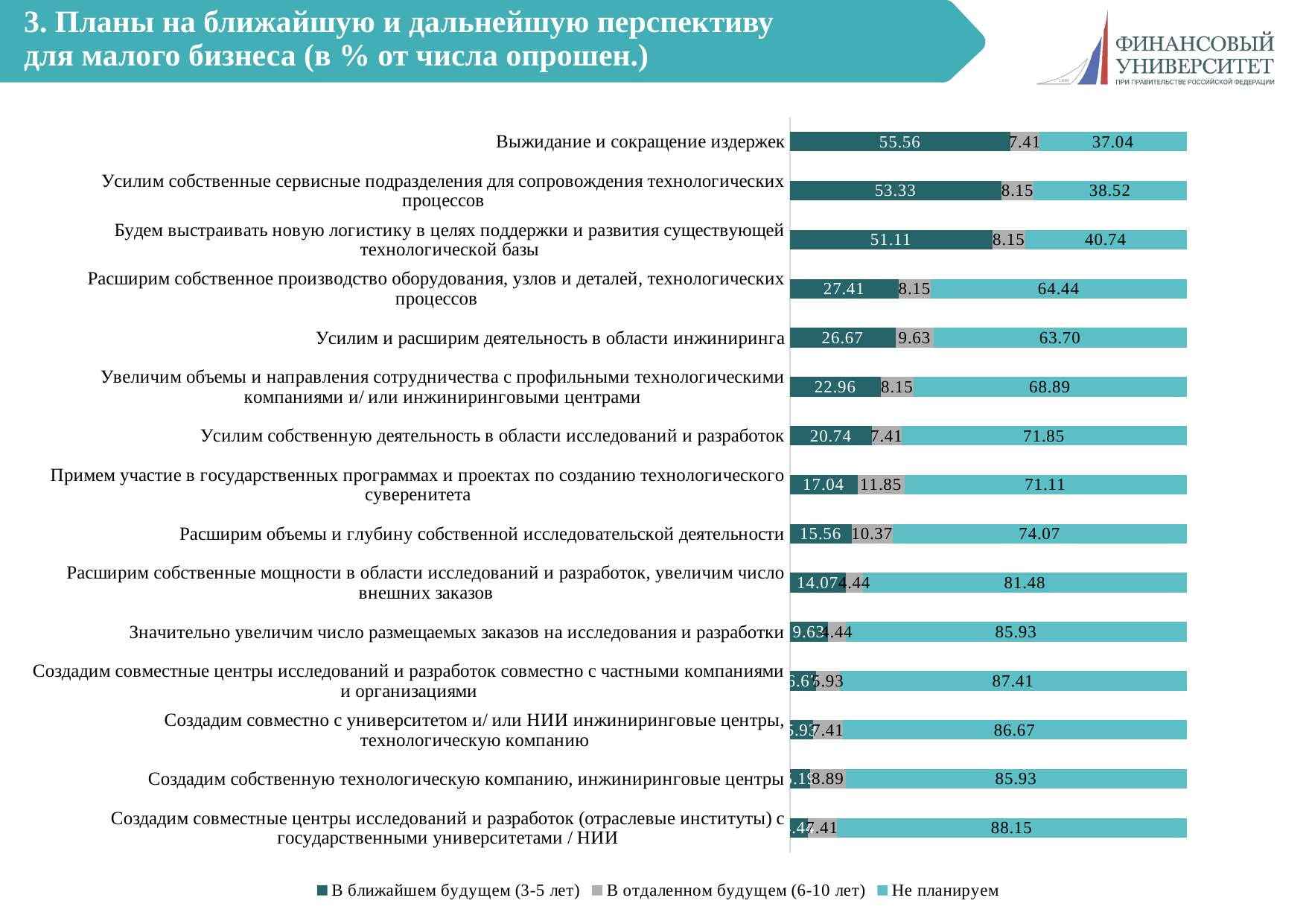
Which legend entry is shown in the lightest teal colour? Не планируем How many categories (plans) are plotted on the chart? 15 Which category has the highest value for «Не планируем»? Создадим совместные центры исследований и разработок (отраслевые институты) с государственными университетами / НИИ What is the total of the stacked bar for «Расширим объемы и глубину собственной исследовательской деятельности»? 100.00 Which is larger: the «Не планируем» value for «Расширим собственное производство оборудования, узлов и деталей, технологических процессов» or for «Увеличим объемы и направления сотрудничества с профильными технологическими компаниями и/ или инжиниринговыми центрами»? Увеличим объемы и направления сотрудничества с профильными технологическими компаниями и/ или инжиниринговыми центрами What is the value of «В отдаленном будущем (6-10 лет)» for «Примем участие в государственных программах и проектах по созданию технологического суверенитета»? 11.85 What kind of chart is shown on the slide? Stacked bar chart What is the value of «Не планируем» for «Усилим и расширим деятельность в области инжиниринга»? 63.70 Which category has the lowest value for «Не планируем»? Выжидание и сокращение издержек What is the difference between the «В ближайшем будущем (3-5 лет)» values for «Выжидание и сокращение издержек» and «Усилим собственную деятельность в области исследований и разработок»? 34.82 How many series does the legend list? 3 What is the value of «В ближайшем будущем (3-5 лет)» for «Выжидание и сокращение издержек»? 55.56